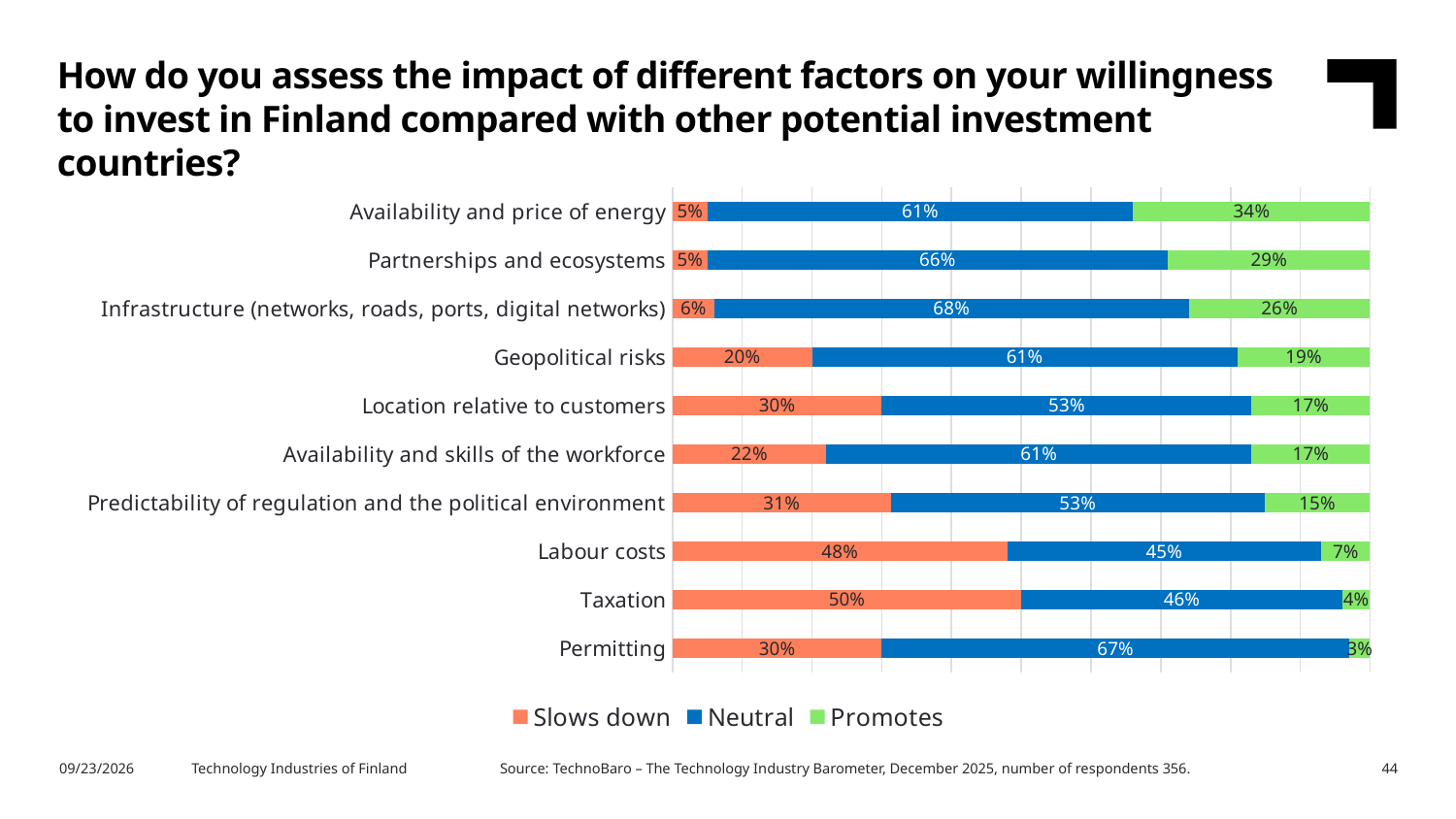
Which factor has the lowest 'Promotes' value? Permitting What is the difference between the 'Slows down' values for Labour costs and Geopolitical risks? 28 percentage points How many factors (categories) are shown in the chart? 10 What type of chart is shown on the slide? Stacked bar chart What is the 'Slows down' value for Taxation? 50% What is the total of the stacked bar for Labour costs? 100% Which factor has the highest 'Slows down' value? Taxation How many series does the legend list? 3 Which has a larger 'Neutral' value: Infrastructure (networks, roads, ports, digital networks) or Location relative to customers? Infrastructure (networks, roads, ports, digital networks) Which factor has the highest 'Promotes' value? Availability and price of energy What percentage of respondents said 'Availability and price of energy' promotes their willingness to invest in Finland? 34% What is the 'Neutral' value for Permitting? 67%